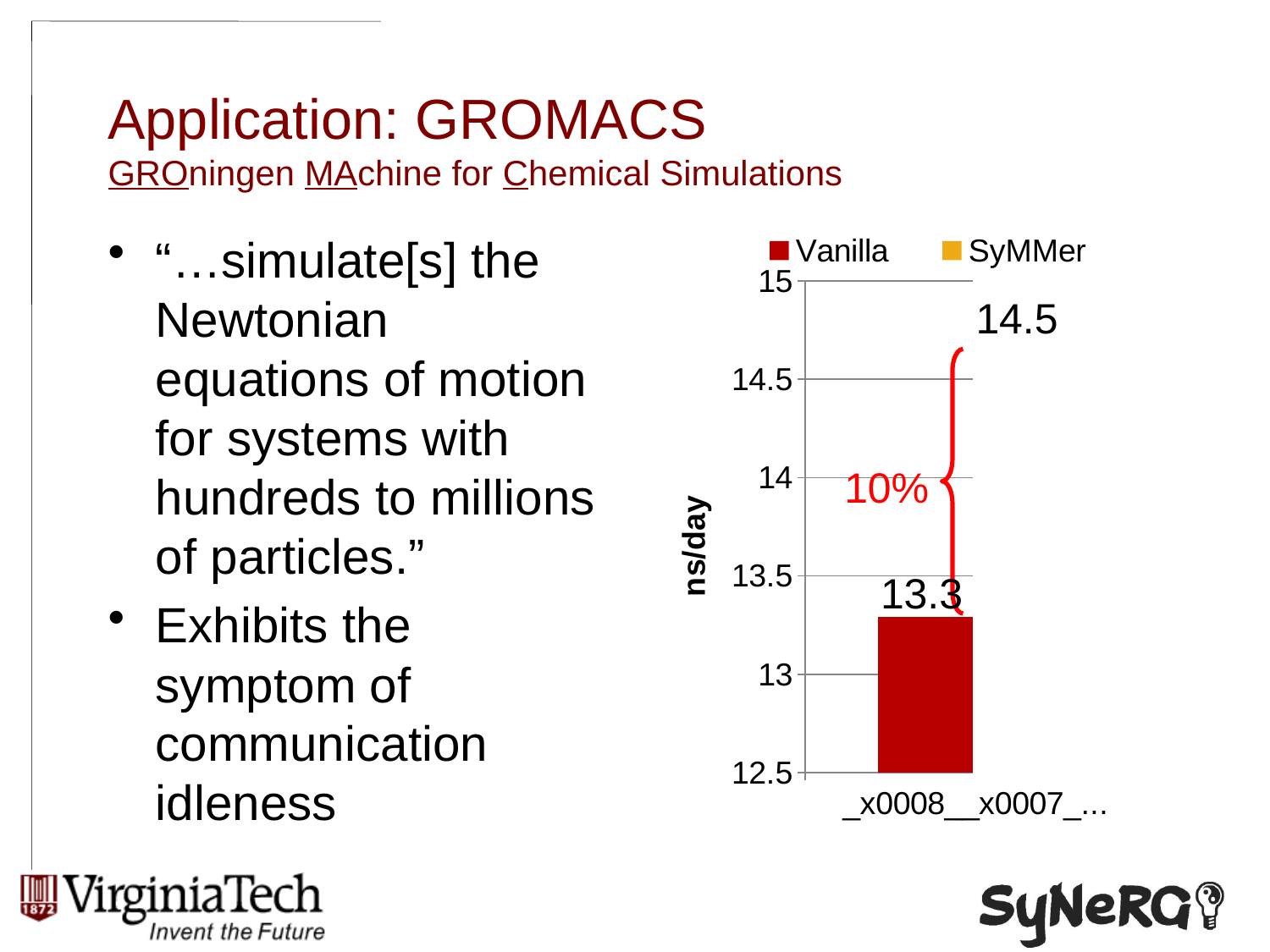
How many series does the legend list? 2 What is the value for the SyMMer series? 14.5 Which series has the lowest value? Vanilla What is the difference between the SyMMer value and the Vanilla value? 1.2 Is the value for Vanilla greater or less than 13.5? less What is the value for the Vanilla series? 13.3 Is the value for SyMMer greater or less than 14? greater What is the maximum value shown on the vertical axis? 15 What kind of chart is shown on the slide? bar chart Which series has the higher value, Vanilla or SyMMer? SyMMer What percentage improvement is annotated in red on the chart? 10% What is the label on the vertical axis of the chart? ns/day